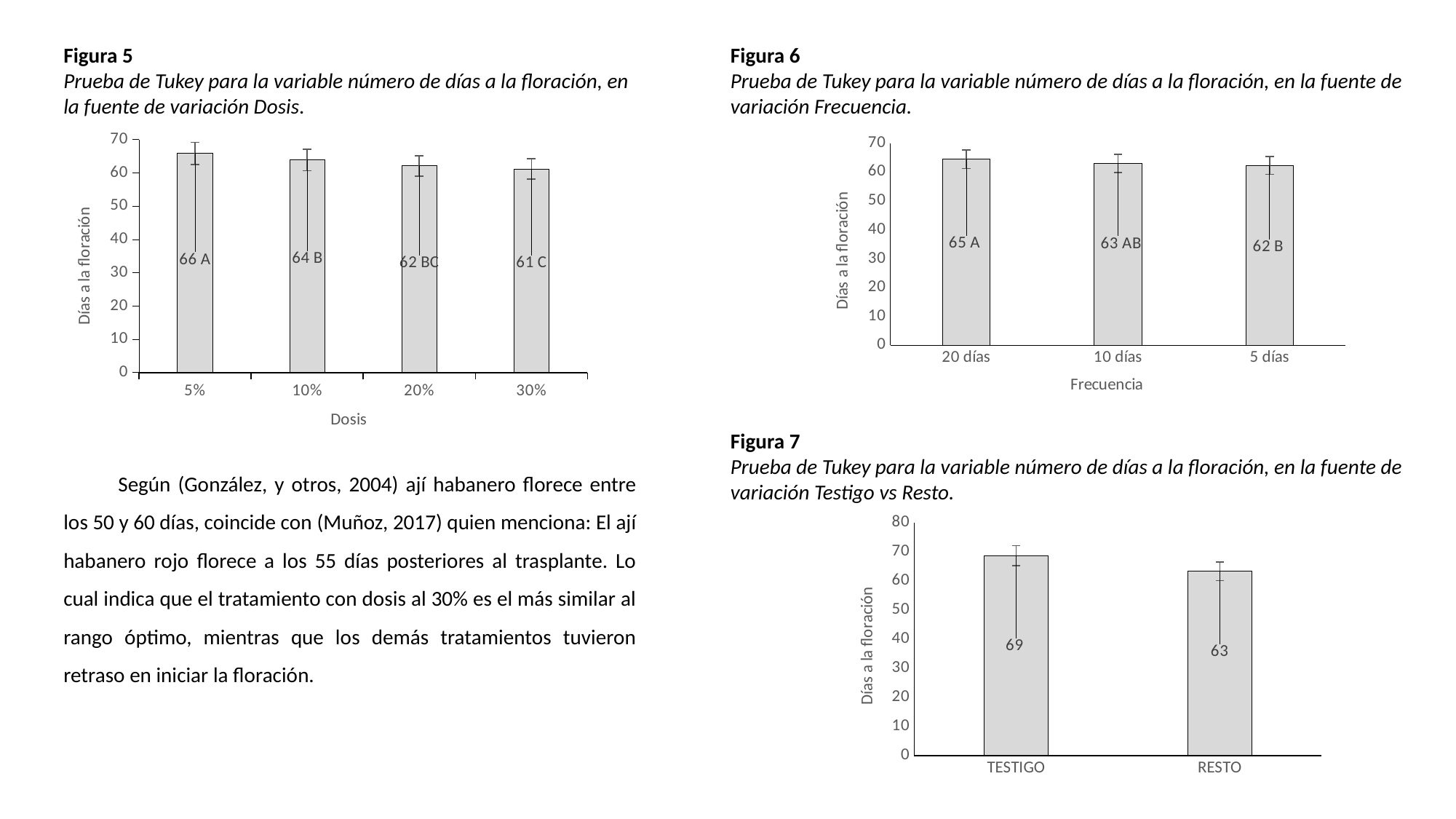
In Figura 7, what is the difference between the TESTIGO and RESTO values? 6 In Figura 5, what is the difference in days to flowering between the 5% dose and the 30% dose? 5 In Figura 5, do the bar values rise or fall as the dose increases from 5% to 30%? fall In Figura 6, what is the data label shown on the bar for 10 días? 63 AB In Figura 7, which is larger, TESTIGO or RESTO? TESTIGO In Figura 7, what is the value for TESTIGO? 69 In Figura 5, what is the data label shown on the bar for the 5% dose? 66 A In Figura 6, which frequency has the highest number of days to flowering? 20 días In Figura 5, which dose has the lowest number of days to flowering? 30% In Figura 6, how many frequency categories are plotted? 3 What kind of chart is Figura 7? bar chart In Figura 5, how many dose categories are shown on the x axis? 4